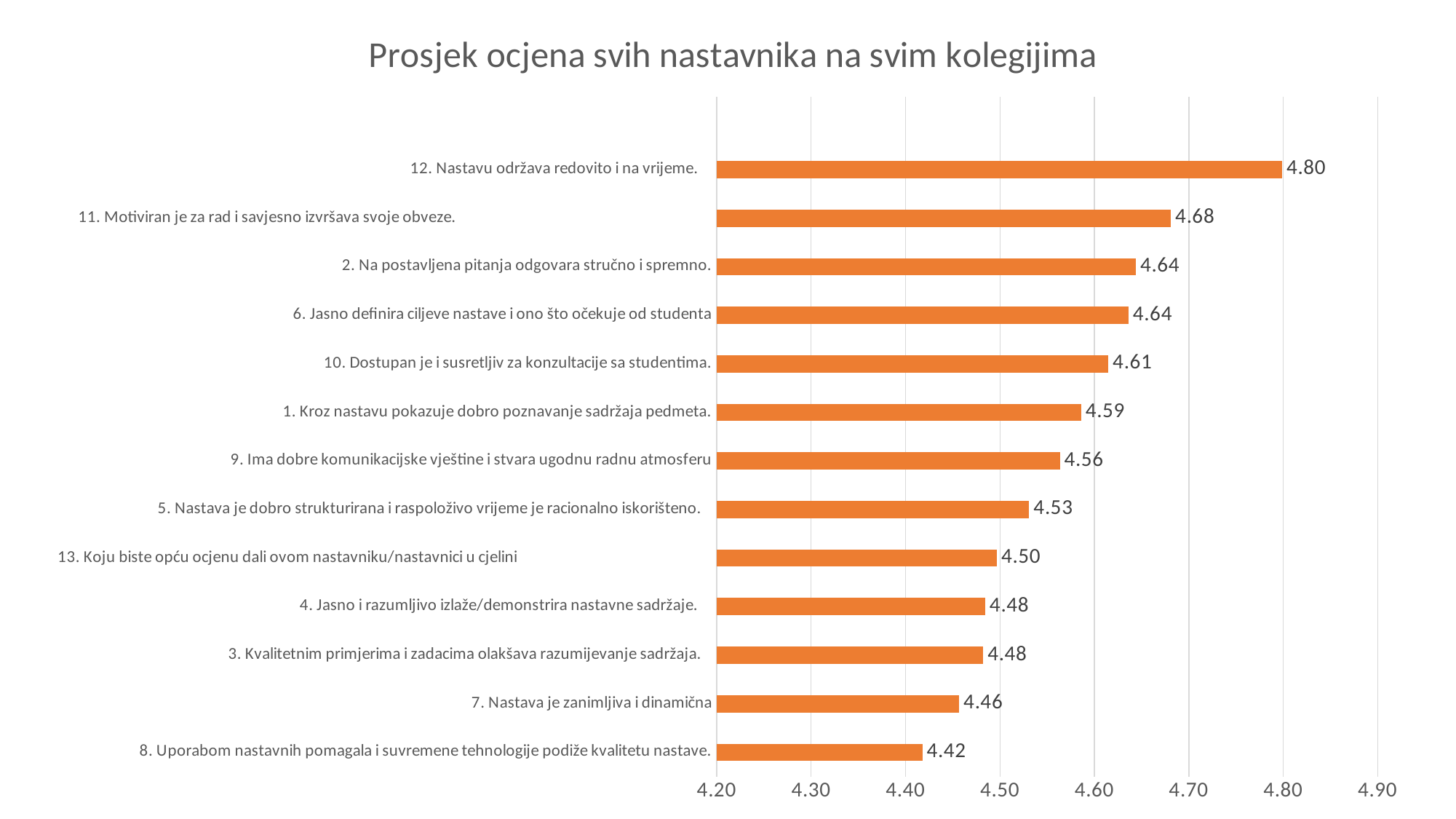
What is the title of the chart? Prosjek ocjena svih nastavnika na svim kolegijima What is the value for "8. Uporabom nastavnih pomagala i suvremene tehnologije podiže kvalitetu nastave."? 4.42 What is the difference between the values for "12. Nastavu održava redovito i na vrijeme." and "8. Uporabom nastavnih pomagala i suvremene tehnologije podiže kvalitetu nastave."? 0.38 What is the difference between the values for "11. Motiviran je za rad i savjesno izvršava svoje obveze." and "7. Nastava je zanimljiva i dinamična"? 0.22 Which category has the lowest value? 8. Uporabom nastavnih pomagala i suvremene tehnologije podiže kvalitetu nastave. What is the value for "13. Koju biste opću ocjenu dali ovom nastavniku/nastavnici u cjelini"? 4.50 Which category has the highest value? 12. Nastavu održava redovito i na vrijeme. How many categories are shown in the chart? 13 What kind of chart is shown on the slide? Bar chart What is the value for "10. Dostupan je i susretljiv za konzultacije sa studentima."? 4.61 Which has a larger value: "9. Ima dobre komunikacijske vještine i stvara ugodnu radnu atmosferu" or "4. Jasno i razumljivo izlaže/demonstrira nastavne sadržaje."? 9. Ima dobre komunikacijske vještine i stvara ugodnu radnu atmosferu What is the value for "12. Nastavu održava redovito i na vrijeme."? 4.80